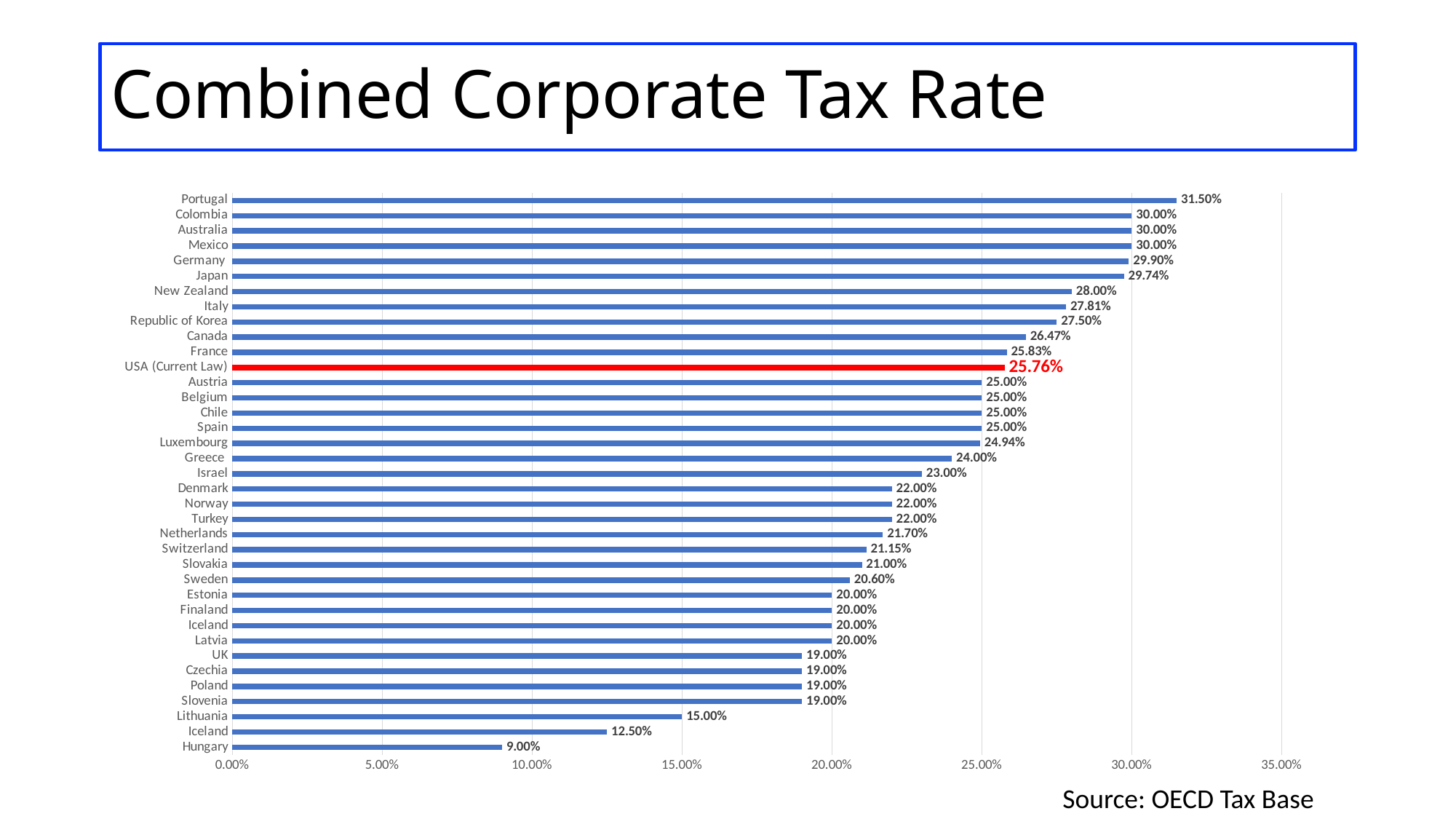
How many countries/categories are plotted on the chart? 37 Which country has the highest combined corporate tax rate on the chart? Portugal Is the value for Lithuania greater or less than 20.00%? less What is the value shown for USA (Current Law)? 25.76% Which bar is highlighted in red on the chart? USA (Current Law) Which country has the lowest combined corporate tax rate on the chart? Hungary What is the combined corporate tax rate shown for Portugal? 31.50% What is the difference between the rates for Portugal and Hungary? 22.50% Which has a higher combined corporate tax rate, Canada or Germany? Germany What kind of chart is shown on the slide? Bar chart What is the combined corporate tax rate shown for Japan? 29.74% What is the difference between the rates for USA (Current Law) and France? 0.07%